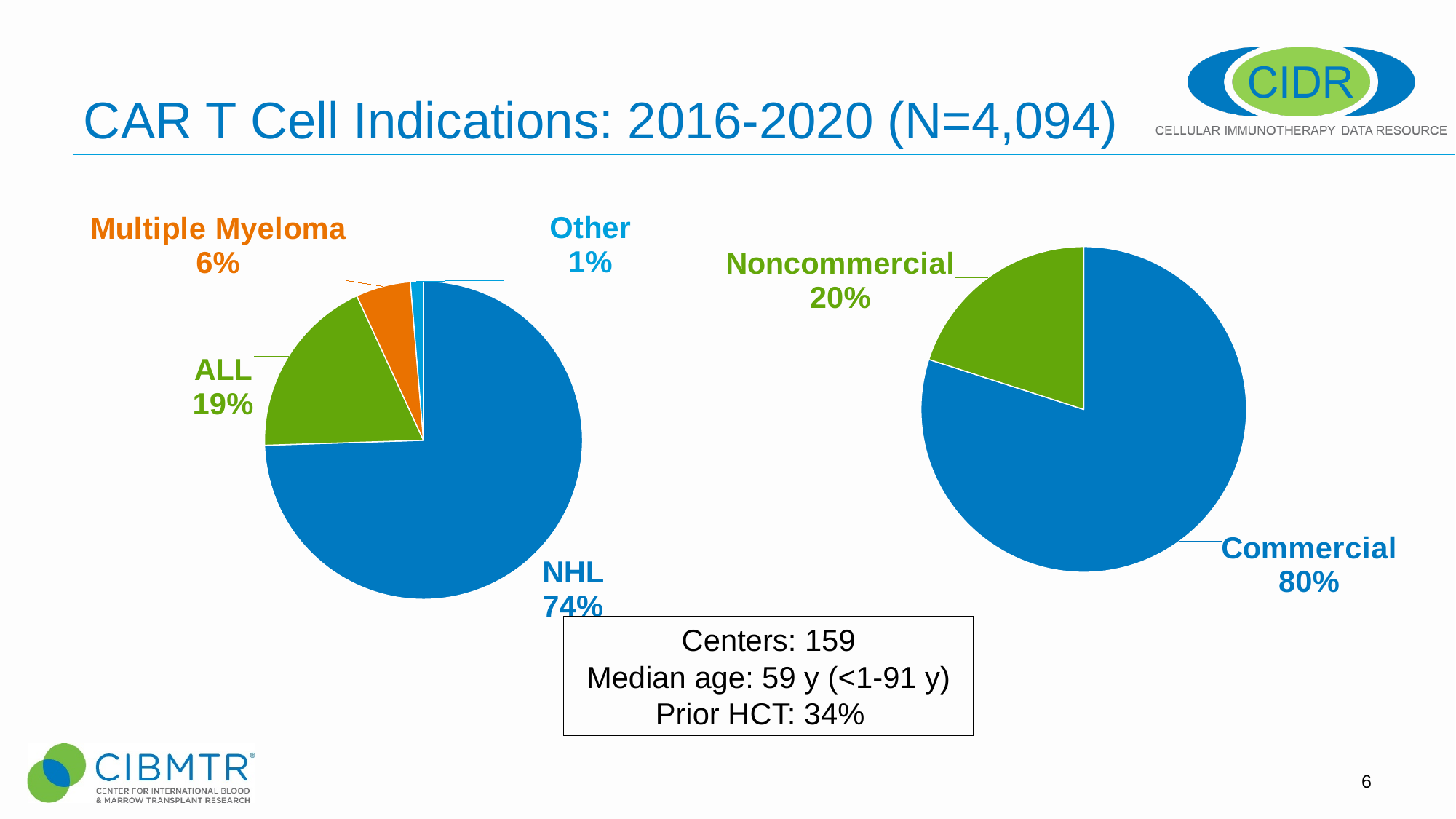
In the left pie chart, what is the difference in percentage points between ALL and Multiple Myeloma? 13 In the left pie chart, which category has the largest slice? NHL In the left pie chart, what percentage is labelled for ALL? 19% In the left pie chart, what share of CAR T cell indications is NHL? 74% In the right pie chart, what share is Commercial? 80% In the left pie chart, how many slices are there? 4 In the right pie chart, which is larger, Commercial or Noncommercial? Commercial In the left pie chart, which category has the smallest slice? Other In the left pie chart, what percentage is labelled for Multiple Myeloma? 6% What kind of chart is shown on the right side of the slide? Pie chart In the right pie chart, what percentage is labelled for Noncommercial? 20% What is the title of the slide containing the two pie charts? CAR T Cell Indications: 2016-2020 (N=4,094)